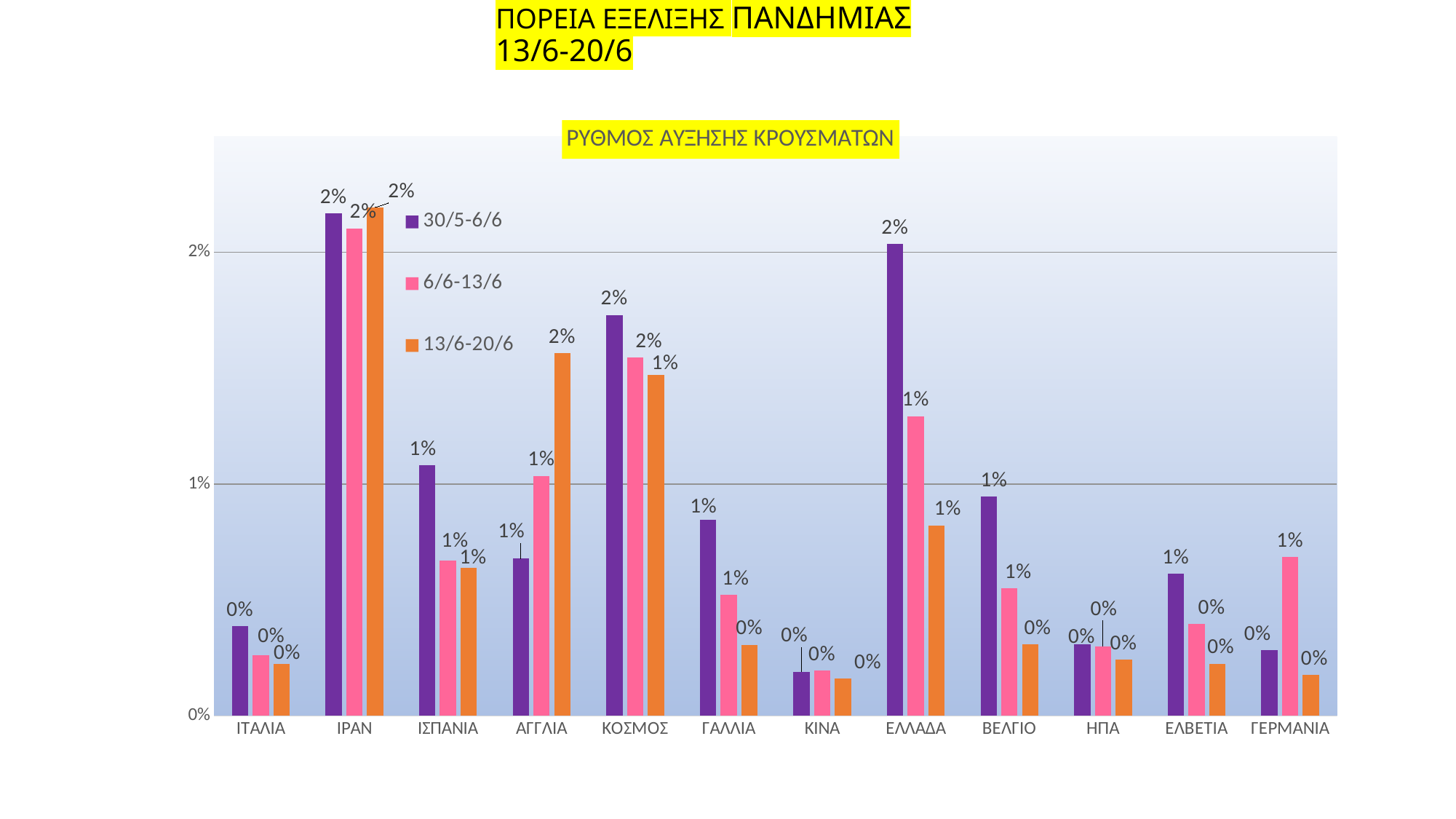
What is the data label for ΙΡΑΝ in the 30/5-6/6 series? 2% What kind of chart is shown on the slide? bar chart Which category has the highest value in the 6/6-13/6 series? ΙΡΑΝ How many countries/categories are shown on the x axis? 12 How many series does the legend list? 3 Is the value for ΚΟΣΜΟΣ in the 30/5-6/6 series greater or less than 2%? less What is the data label for ΚΙΝΑ in the 13/6-20/6 series? 0% Which category has the highest value in the 30/5-6/6 series? ΙΡΑΝ For ΕΛΛΑΔΑ, which is larger: the 30/5-6/6 value or the 13/6-20/6 value? 30/5-6/6 What is the data label for ΑΓΓΛΙΑ in the 13/6-20/6 series? 2% What is the title of the chart? ΡΥΘΜΟΣ ΑΥΞΗΣΗΣ ΚΡΟΥΣΜΑΤΩΝ Is the value for ΑΓΓΛΙΑ in the 13/6-20/6 series greater or less than 1%? greater